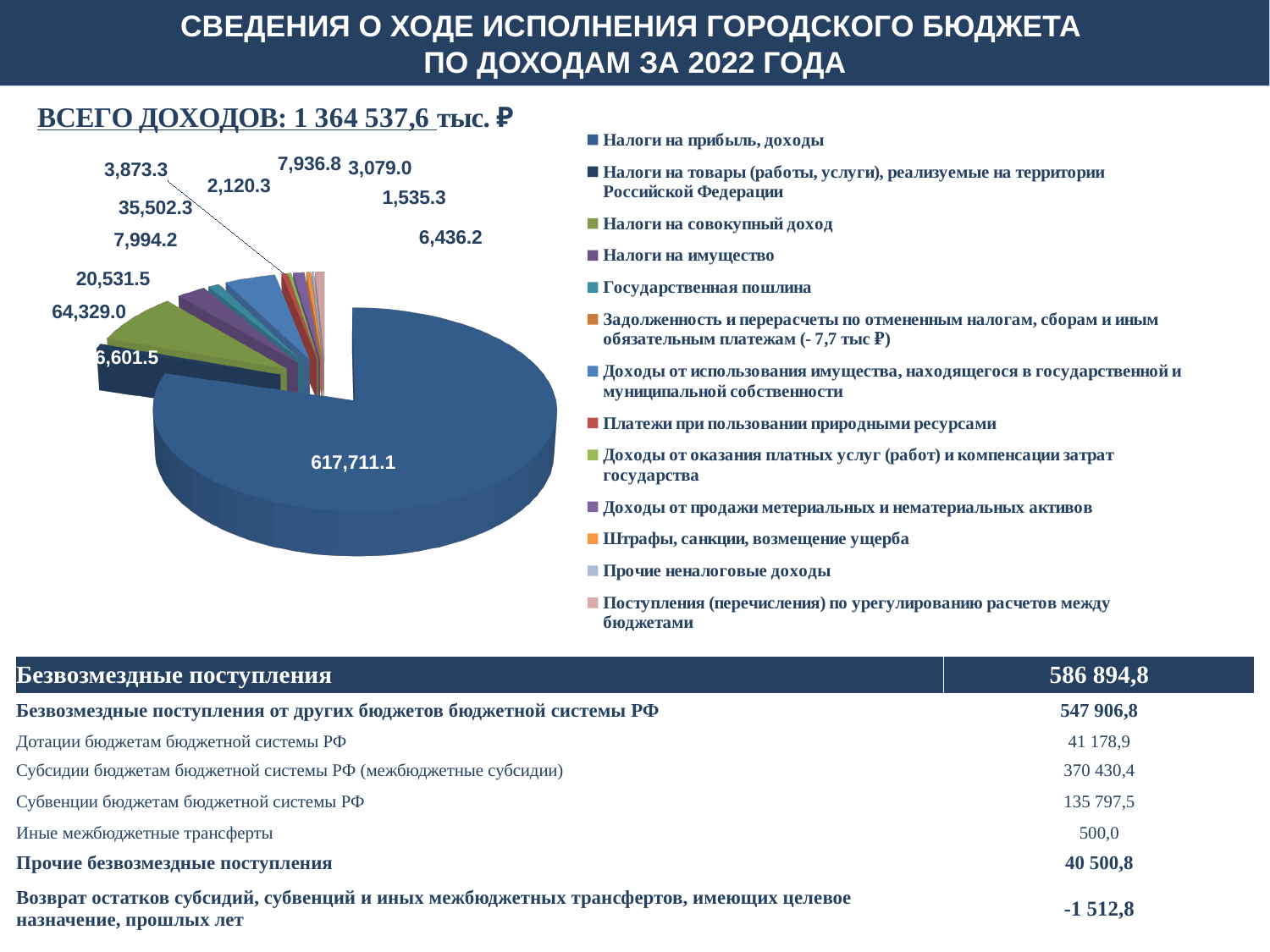
What is the largest value labelled on the pie chart? 617,711.1 Which legend category corresponds to the largest slice of the pie chart? Налоги на прибыль, доходы How many data labels are printed on the pie chart? 12 What total income (ВСЕГО ДОХОДОВ) is stated above the pie chart? 1 364 537,6 тыс. ₽ Which is larger on the pie chart: the slice labelled 64,329.0 or the slice labelled 35,502.3? 64,329.0 What value is labelled on the green slice (Налоги на совокупный доход) of the pie chart? 64,329.0 What negative amount is noted in the legend entry for Задолженность и перерасчеты по отмененным налогам? - 7,7 тыс ₽ How many entries does the legend of the pie chart list? 13 Is the value of the slice labelled 20,531.5 greater or less than 10,000? greater What is the difference between the slice labelled 617,711.1 and the slice labelled 64,329.0? 553,382.1 What is the smallest value labelled on the pie chart? 1,535.3 What kind of chart is shown on the slide? pie chart